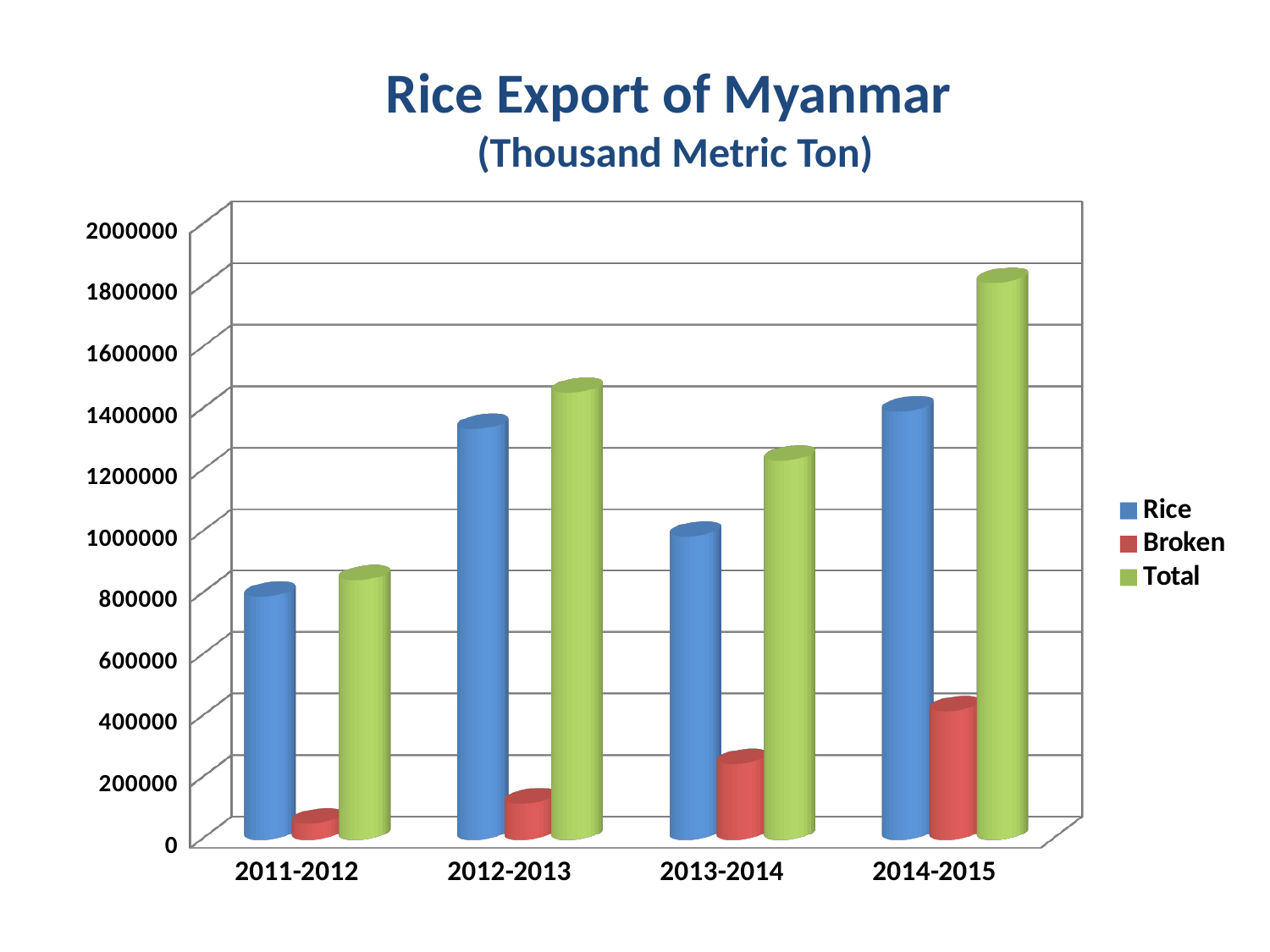
Do the Broken values rise or fall from 2011-2012 to 2014-2015? rise What is the title of the chart? Rice Export of Myanmar (Thousand Metric Ton) What kind of chart is shown on the slide? bar chart Is the Total value for 2014-2015 greater or less than 1600000? greater Is the Broken value for 2011-2012 greater or less than 200000? less Which is larger, the Total value for 2012-2013 or the Total value for 2013-2014? 2012-2013 How many series does the legend list? 3 In which year is the Broken value lowest? 2011-2012 How many year categories are shown on the x axis? 4 In which year is the Total value highest? 2014-2015 Is the Rice value for 2011-2012 greater or less than 1000000? less